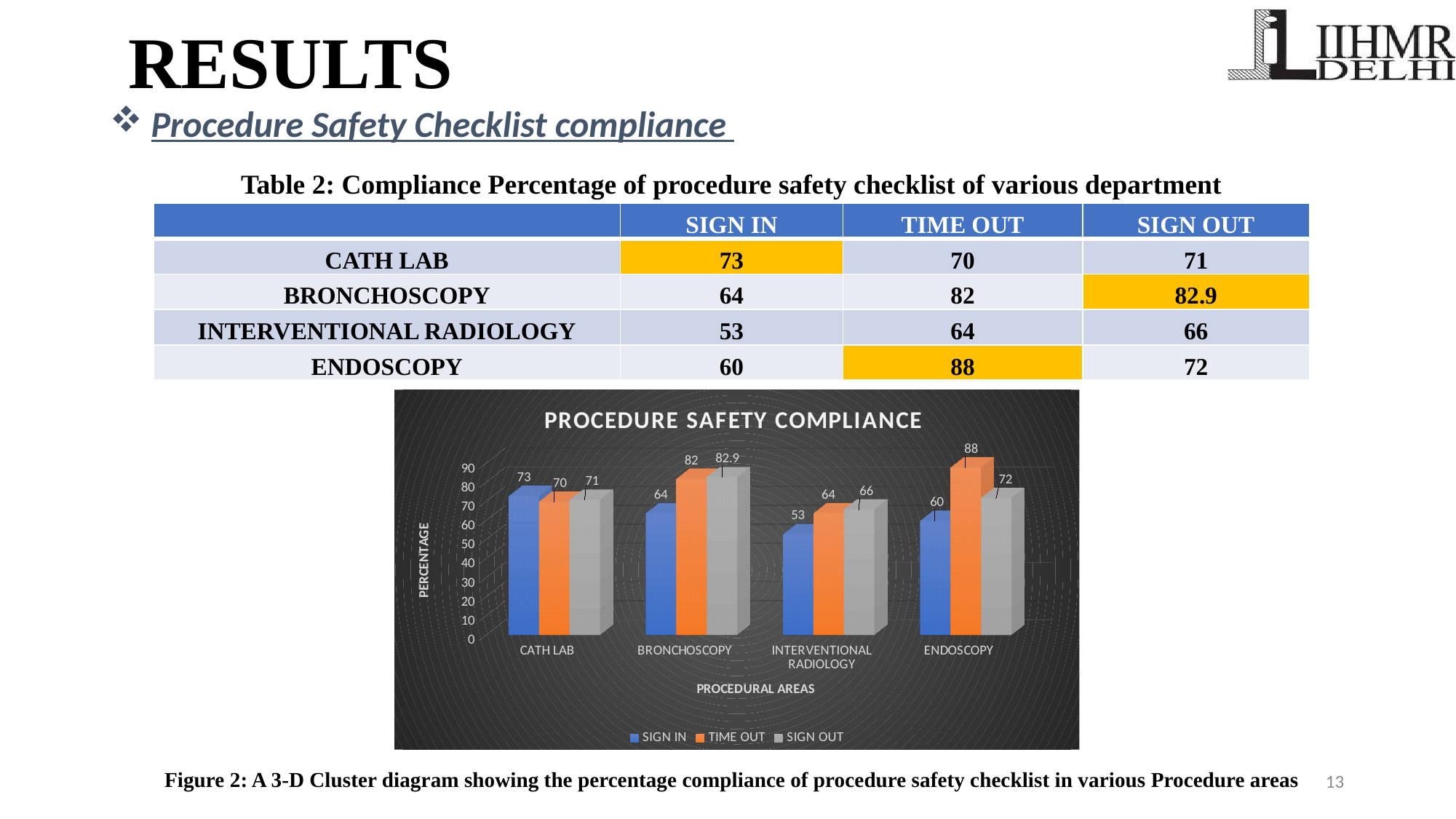
What is the TIME OUT value for ENDOSCOPY in the Procedure Safety Compliance chart? 88 What kind of chart is the Procedure Safety Compliance chart? bar chart Which procedural area has the lowest SIGN IN value in the Procedure Safety Compliance chart? INTERVENTIONAL RADIOLOGY How many series does the legend of the Procedure Safety Compliance chart list? 3 What is the y-axis label of the Procedure Safety Compliance chart? PERCENTAGE What is the SIGN IN value for CATH LAB in the Procedure Safety Compliance chart? 73 In the Procedure Safety Compliance chart, is the SIGN OUT value for INTERVENTIONAL RADIOLOGY larger or smaller than the SIGN OUT value for ENDOSCOPY? smaller What is the difference between the TIME OUT and SIGN IN values for ENDOSCOPY in the Procedure Safety Compliance chart? 28 Which colour represents the TIME OUT series in the Procedure Safety Compliance chart? orange How many procedural areas are shown on the x axis of the Procedure Safety Compliance chart? 4 What is the SIGN OUT value for BRONCHOSCOPY in the Procedure Safety Compliance chart? 82.9 Which procedural area has the highest TIME OUT value in the Procedure Safety Compliance chart? ENDOSCOPY